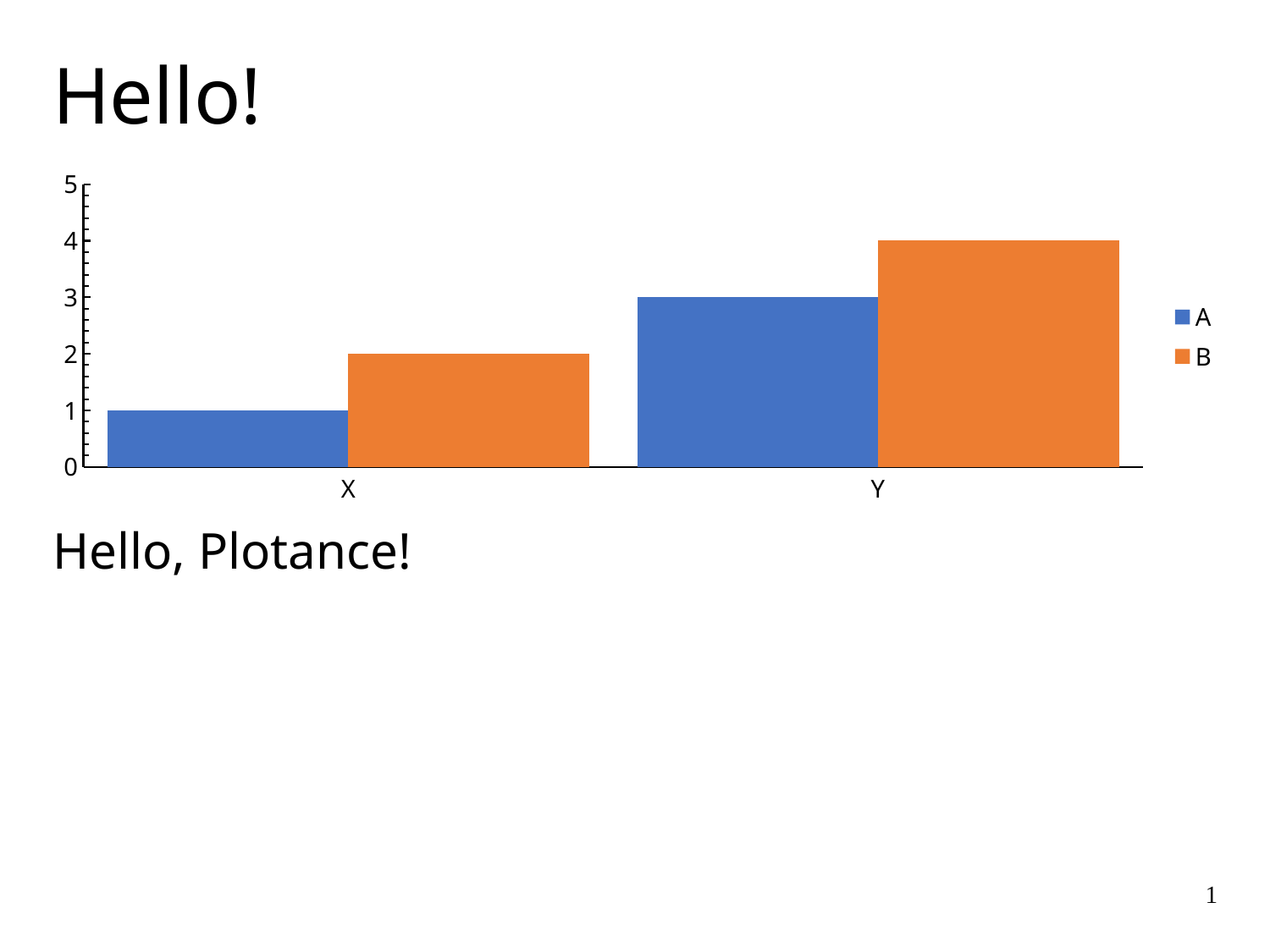
What colour are the bars for series B? orange What is the value of series A for category X? 1 What kind of chart is shown on the slide? bar chart Do the values of series A rise or fall from X to Y? rise How many categories are shown on the x axis? 2 Which is larger for category X: series A or series B? B Which category has the lowest value for series A? X How many series does the legend list? 2 What is the value of series A for category Y? 3 What is the value of series B for category Y? 4 Which category has the highest value for series B? Y What is the difference between series B and series A for category Y? 1